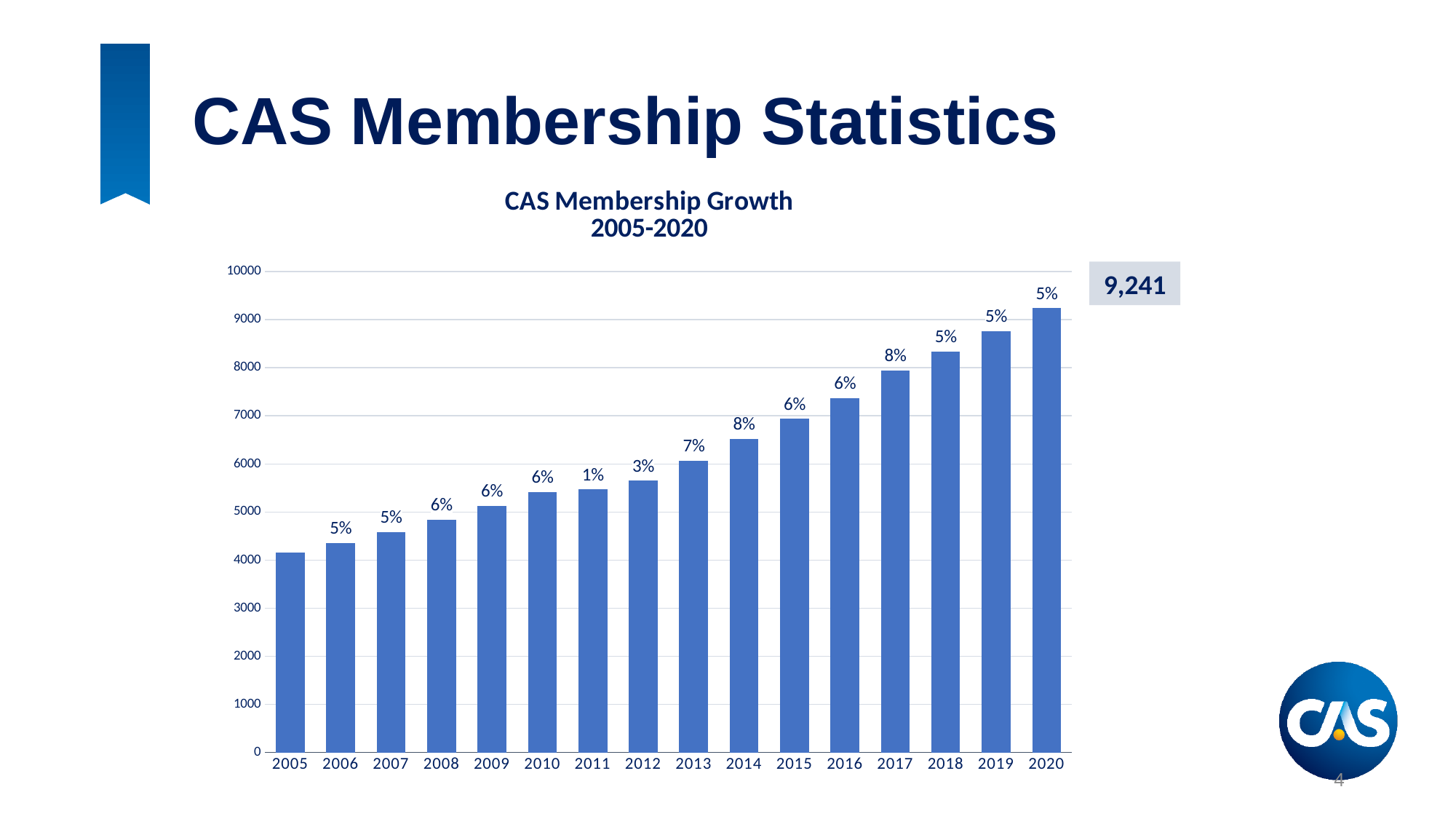
What membership figure is shown in the callout for 2020? 9,241 How many years (bars) are plotted in the chart? 16 Is the membership value for 2016 greater or less than 7000? greater Which year has the larger membership value, 2005 or 2020? 2020 Is the membership value for 2020 greater or less than 9000? greater What is the growth percentage label shown above the 2014 bar? 8% What is the growth percentage label shown above the 2011 bar? 1% What is the title of the chart? CAS Membership Growth 2005-2020 Which year has the lowest growth percentage label? 2011 Do the membership values rise or fall from 2005 to 2020? rise What kind of chart is shown on the slide? bar chart Is the membership value for 2005 greater or less than 5000? less